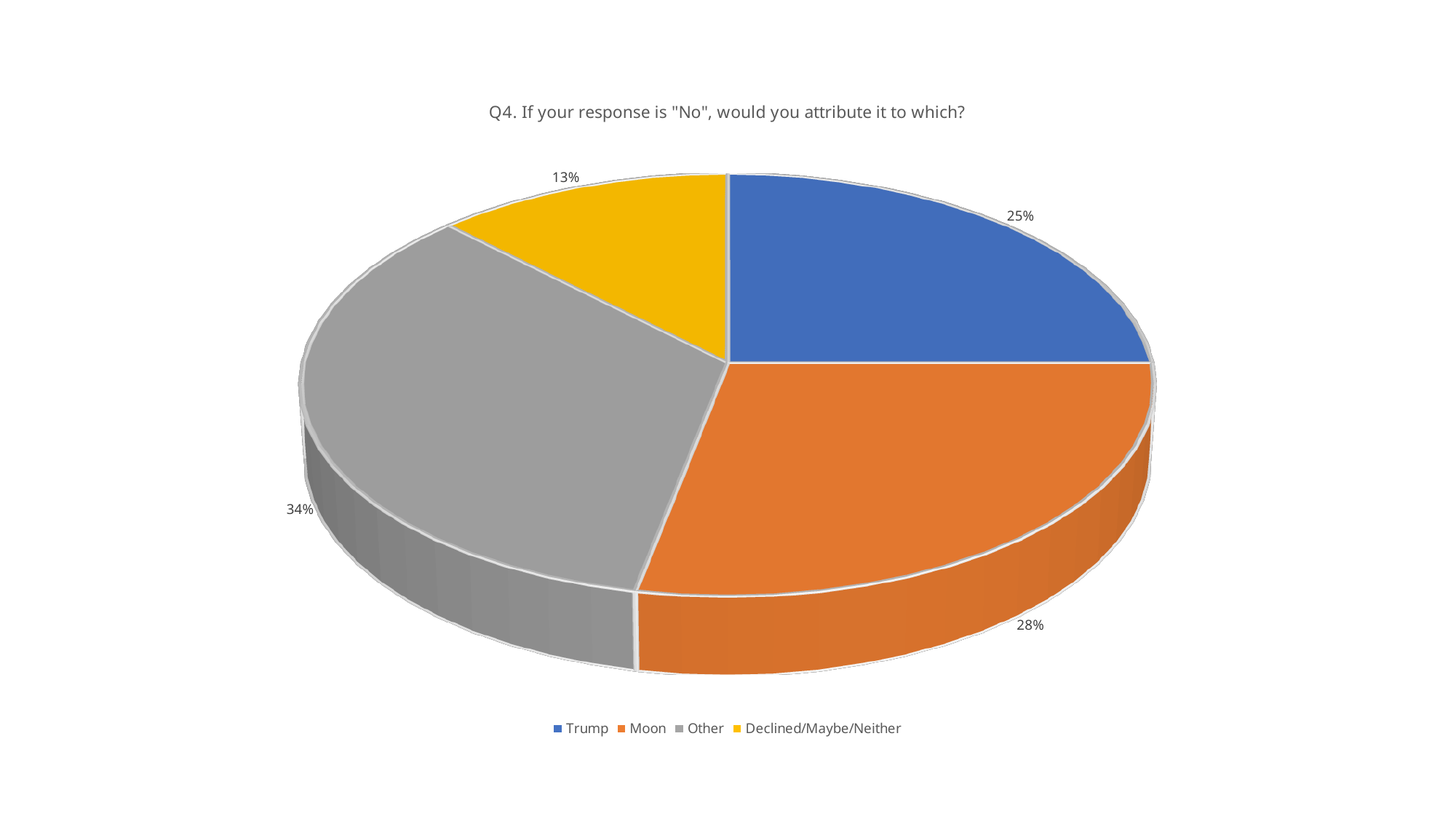
What share of the pie does Other account for? 34% What is the difference in percentage points between the Other slice and the Trump slice? 9 What share of the pie does Declined/Maybe/Neither account for? 13% What kind of chart is shown on the slide? pie chart What is the difference in percentage points between the Moon slice and the Declined/Maybe/Neither slice? 15 What is the title of the chart? Q4. If your response is "No", would you attribute it to which? How many categories does the pie chart have? 4 What share of the pie does Moon account for? 28% Which category has the largest slice of the pie? Other Which category has the smallest slice of the pie? Declined/Maybe/Neither Which is larger, the Moon slice or the Trump slice? Moon